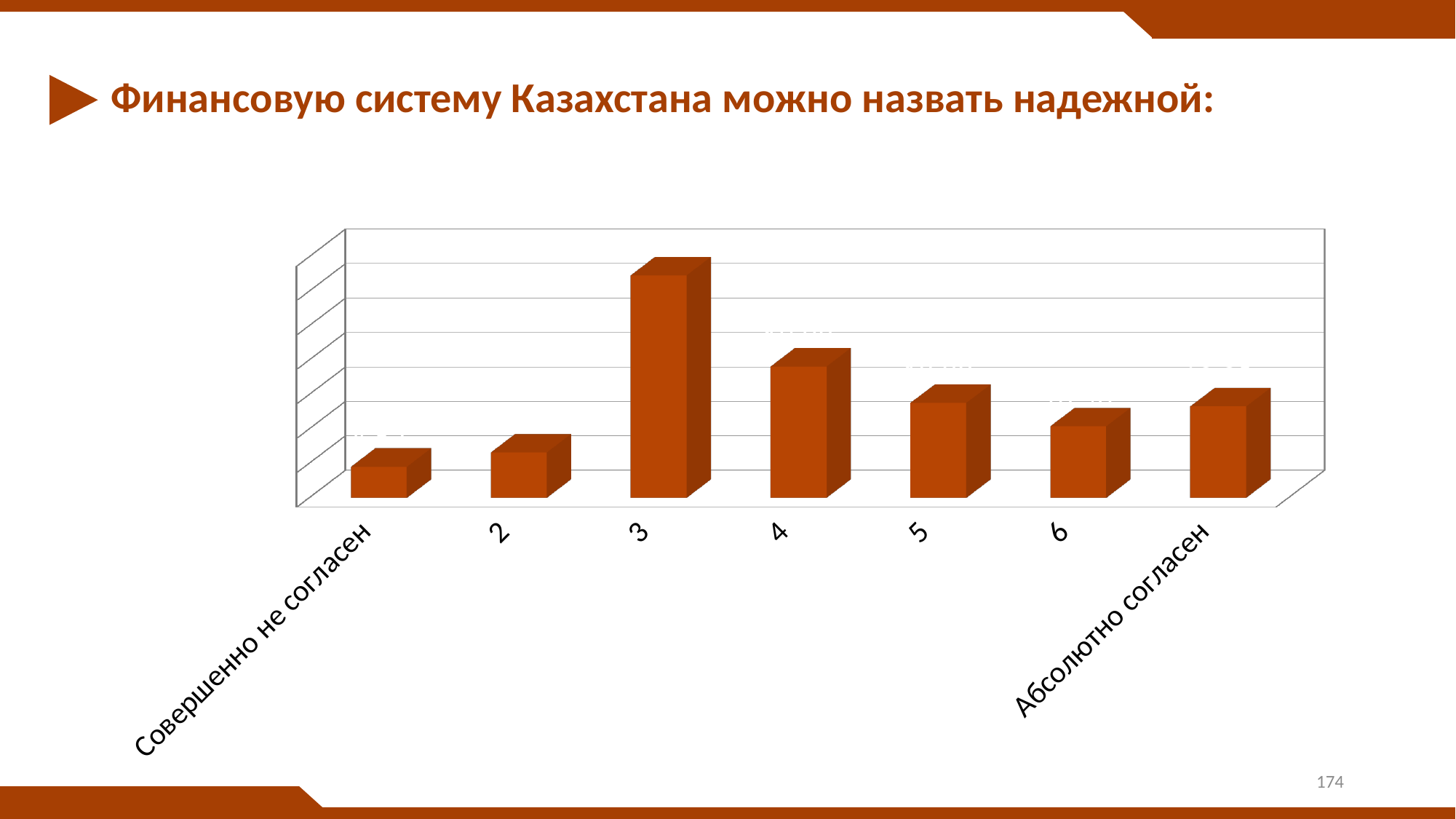
Which category has the lowest bar? Совершенно не согласен Which is larger, the value for Совершенно не согласен or the value for Абсолютно согласен? Абсолютно согласен Do the values rise or fall from Совершенно не согласен to category 3? rise Which is larger, the value for 3 or the value for 4? 3 Do the values rise or fall from category 3 to category 6? fall Which is larger, the value for 4 or the value for 5? 4 What is the label of the first category on the x axis? Совершенно не согласен Which category has the highest bar? 3 How many categories are shown on the x axis of the chart? 7 What kind of chart is shown on the slide? bar chart What is the title of the slide's chart? Финансовую систему Казахстана можно назвать надежной: